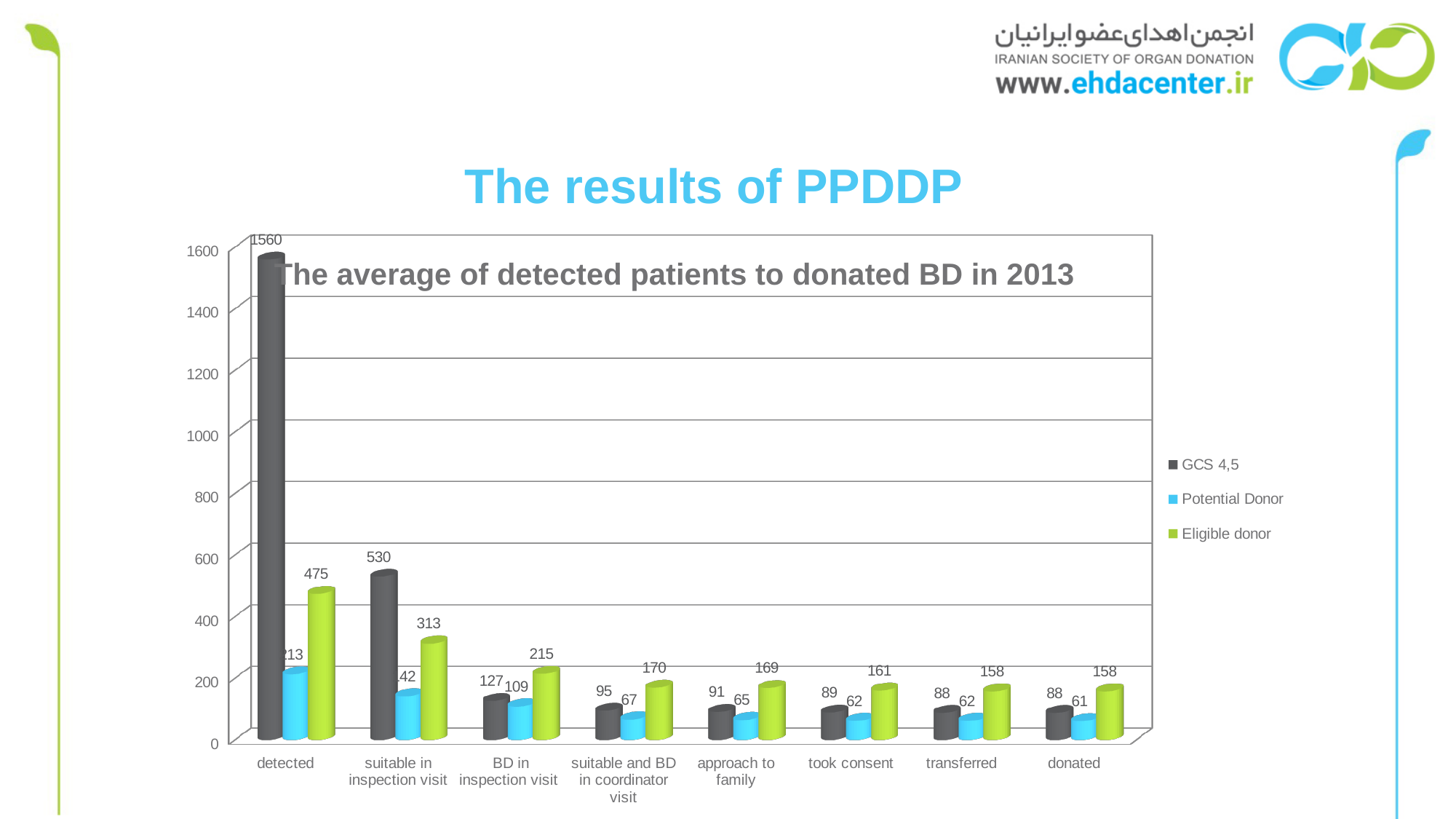
What kind of chart is shown? bar chart What is the Eligible donor value for donated? 158 Which category has the highest GCS 4,5 value? detected Which category has the lowest Potential Donor value? donated What is the Potential Donor value for BD in inspection visit? 109 Which is larger for took consent: the GCS 4,5 value or the Eligible donor value? Eligible donor How many series does the legend list? 3 What is the title of the chart? The average of detected patients to donated BD in 2013 How many categories are shown on the x axis? 8 What is the value for GCS 4,5 in the detected category? 1560 What is the difference between the GCS 4,5 value for detected and for suitable in inspection visit? 1030 What is the Eligible donor value for suitable in inspection visit? 313